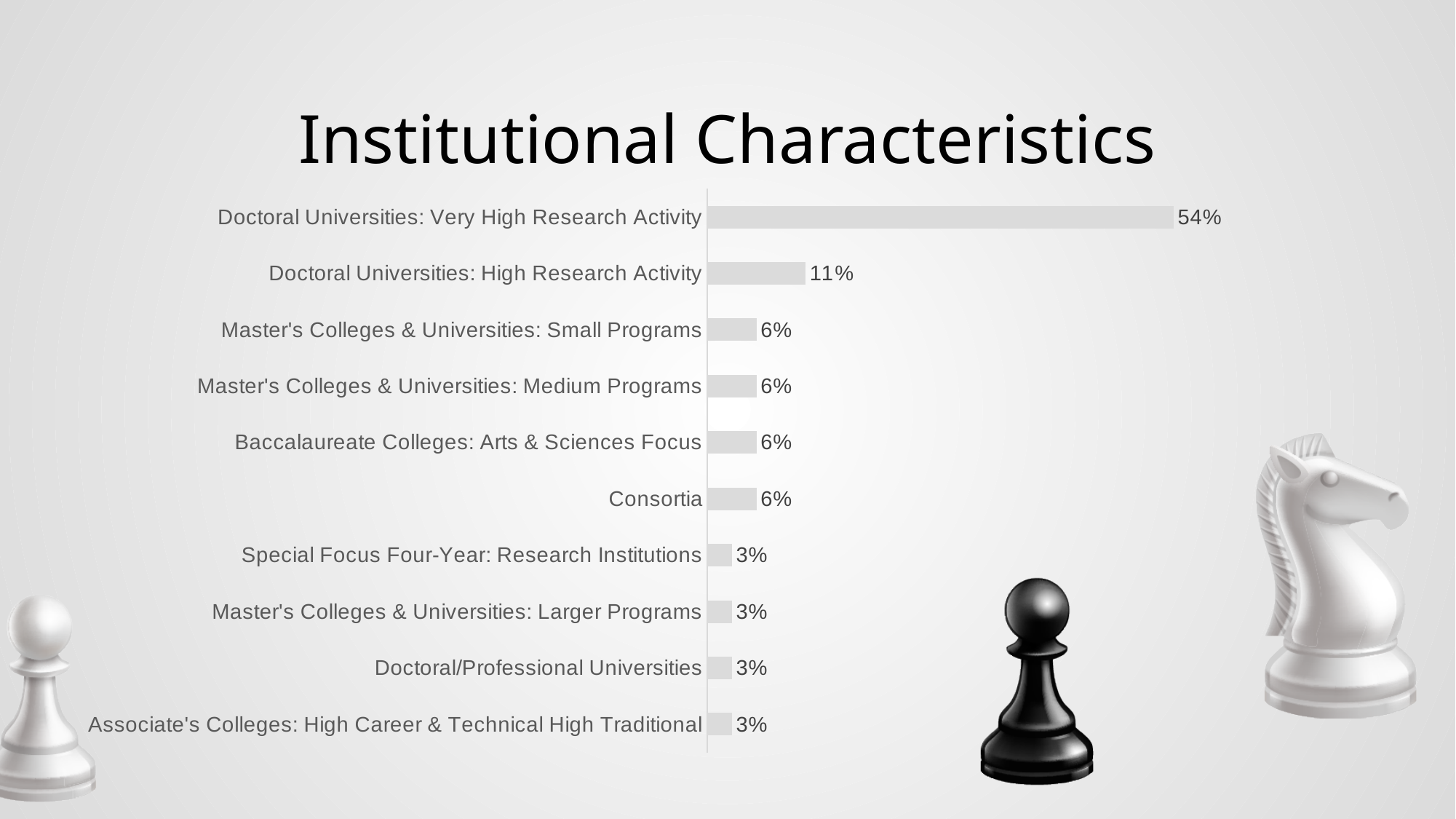
Which is larger, Baccalaureate Colleges: Arts & Sciences Focus or Special Focus Four-Year: Research Institutions? Baccalaureate Colleges: Arts & Sciences Focus What is the difference between Master's Colleges & Universities: Small Programs and Master's Colleges & Universities: Larger Programs? 3% What is the value for Doctoral/Professional Universities? 3% What is the difference between Doctoral Universities: Very High Research Activity and Doctoral Universities: High Research Activity? 43% What is the title of the slide? Institutional Characteristics What kind of chart is shown on the slide? Bar chart What is the value for Consortia? 6% Which category has the highest value? Doctoral Universities: Very High Research Activity How many categories are shown in the chart? 10 What is the value for Doctoral Universities: Very High Research Activity? 54% How many categories have a value of 3%? 4 What is the value for Doctoral Universities: High Research Activity? 11%